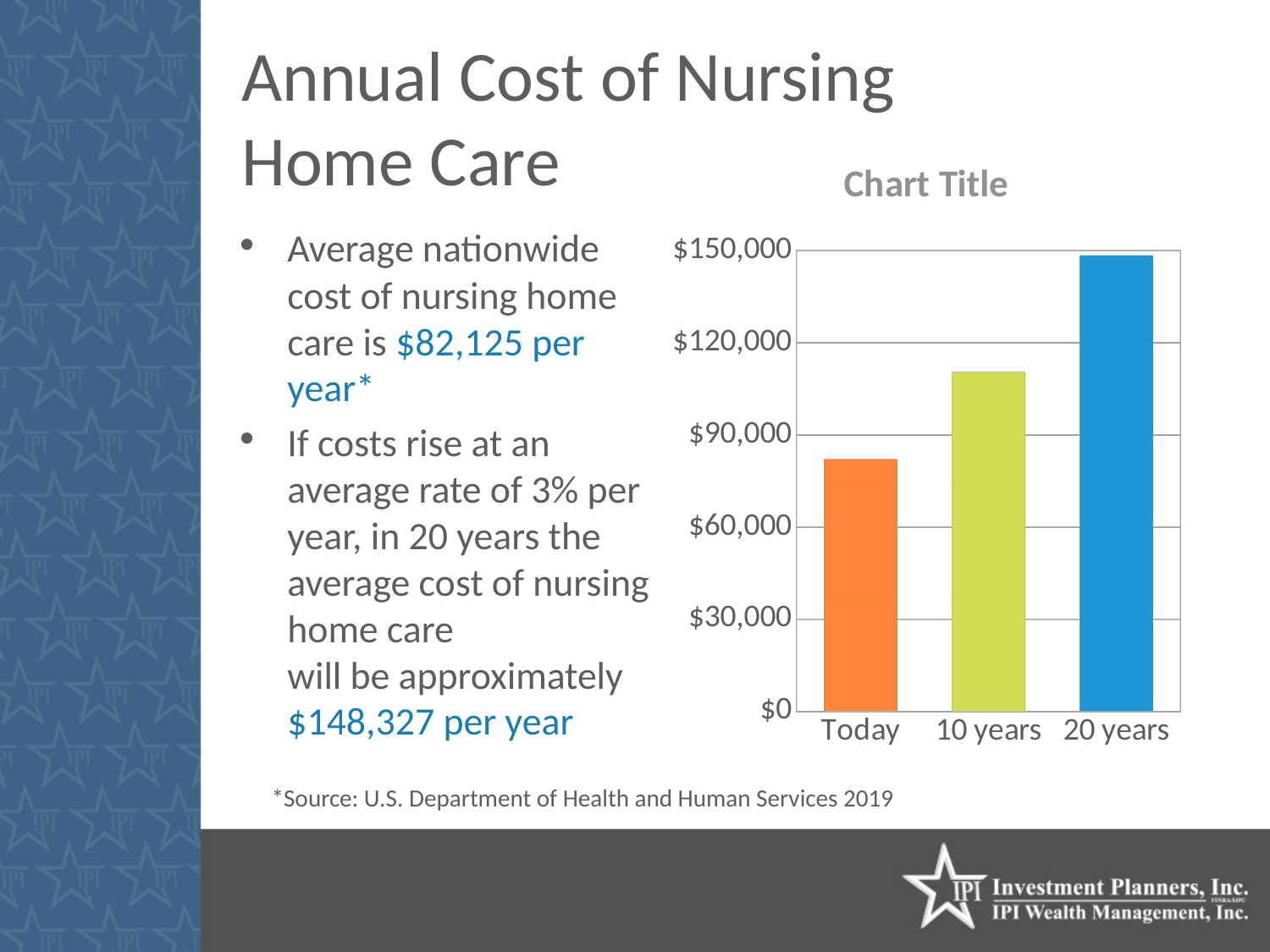
Which category has the highest bar in the chart? 20 years Is the value for Today greater or less than $60,000? greater How many categories are shown on the x axis of the chart? 3 Do the values rise or fall from Today to 20 years along the x axis? rise Is the value for Today greater or less than $90,000? less Is the value for 20 years greater or less than $120,000? greater What colour is the bar for Today? orange Which is larger, the value for 10 years or the value for Today? 10 years Which category has the lowest bar in the chart? Today What kind of chart is shown on the slide? bar chart